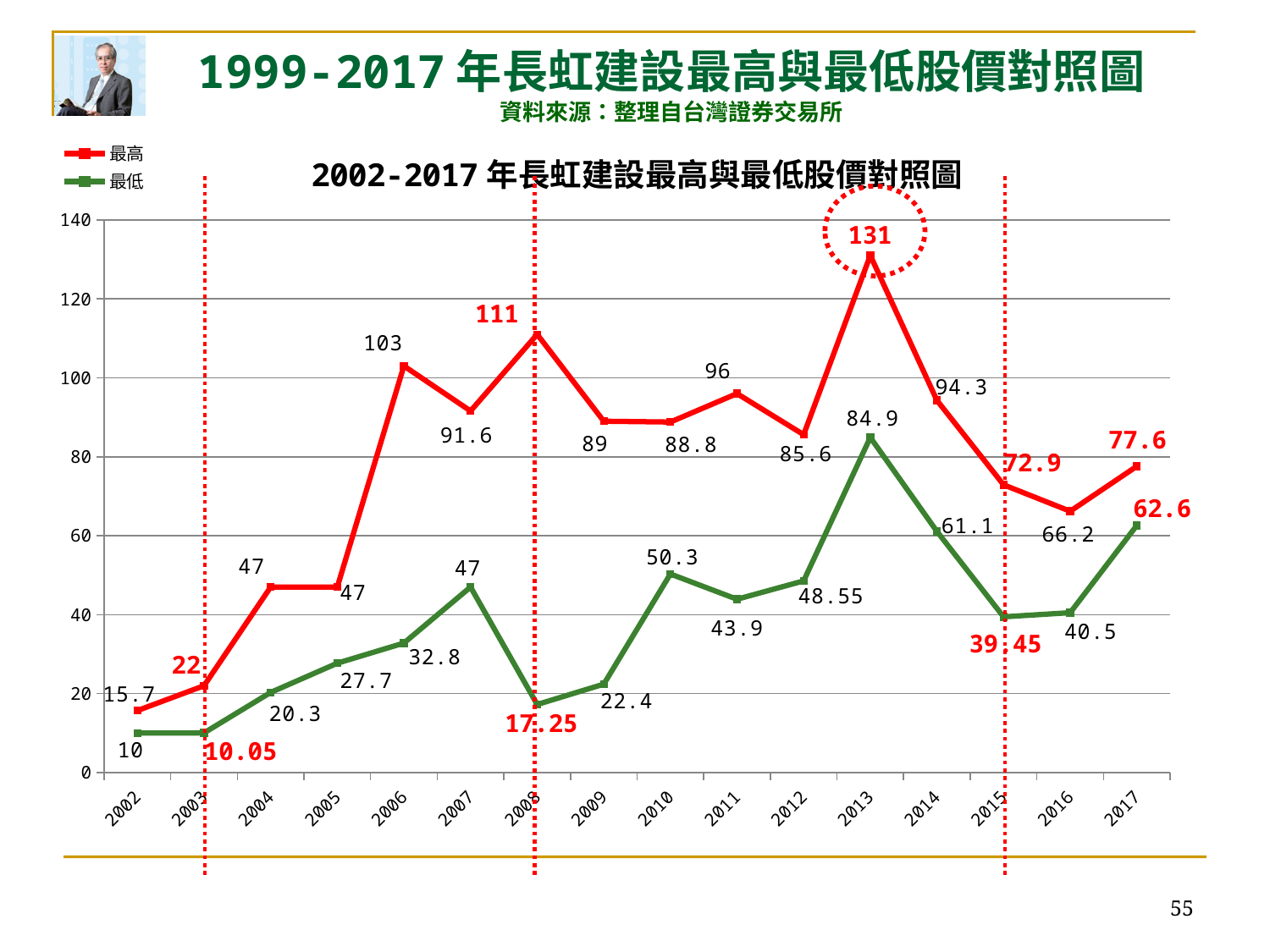
What kind of chart is this? line chart What is the 最低 value for 2015? 39.45 In which year is the 最高 series at its highest? 2013 In which year is the 最低 series at its lowest? 2002 Does the 最低 series rise or fall from 2002 to 2007? rise What is the difference between the 最高 and 最低 values in 2013? 46.1 What is the 最高 value for 2017? 77.6 Which is larger, the 最高 value for 2006 or the 最高 value for 2008? 2008 How many years are shown on the x axis? 16 What is the 最低 value for 2008? 17.25 What is the 最高 value for 2013? 131 How many series does the legend list? 2